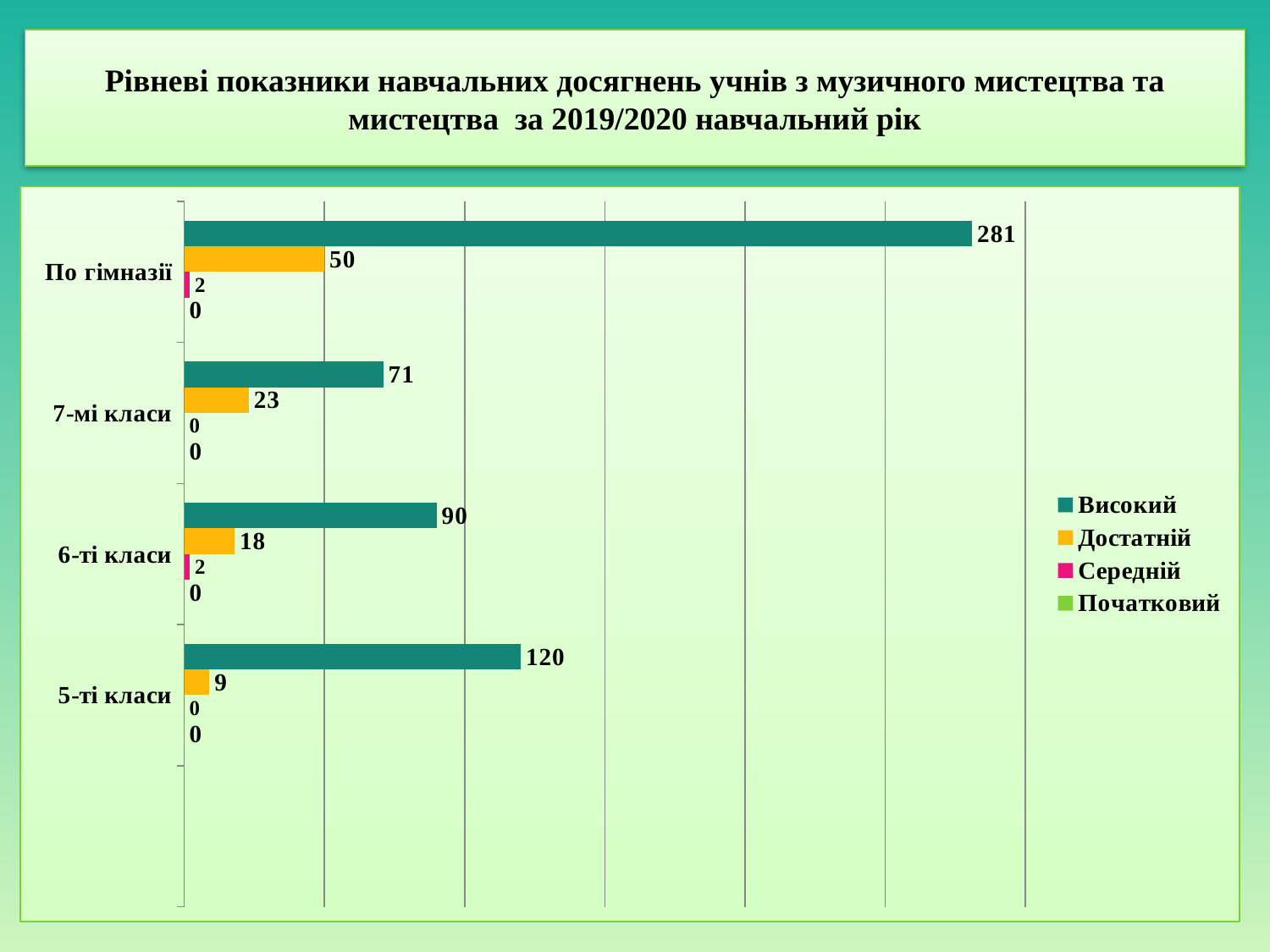
What kind of chart is shown on the slide? bar chart Which is larger: the Високий value for 6-ті класи or for 7-мі класи? 6-ті класи What is the value of Середній for 6-ті класи? 2 What is the difference between the Високий values for 5-ті класи and 7-мі класи? 49 How many series does the legend list? 4 Which class group has the lowest Достатній value? 5-ті класи What is the value of Достатній for 7-мі класи? 23 What is the value of Високий for По гімназії? 281 Which class group has the highest Високий value (excluding По гімназії)? 5-ті класи What is the value of Достатній for 5-ті класи? 9 Which series is shown in orange in the legend? Достатній How many categories are shown on the vertical axis? 4